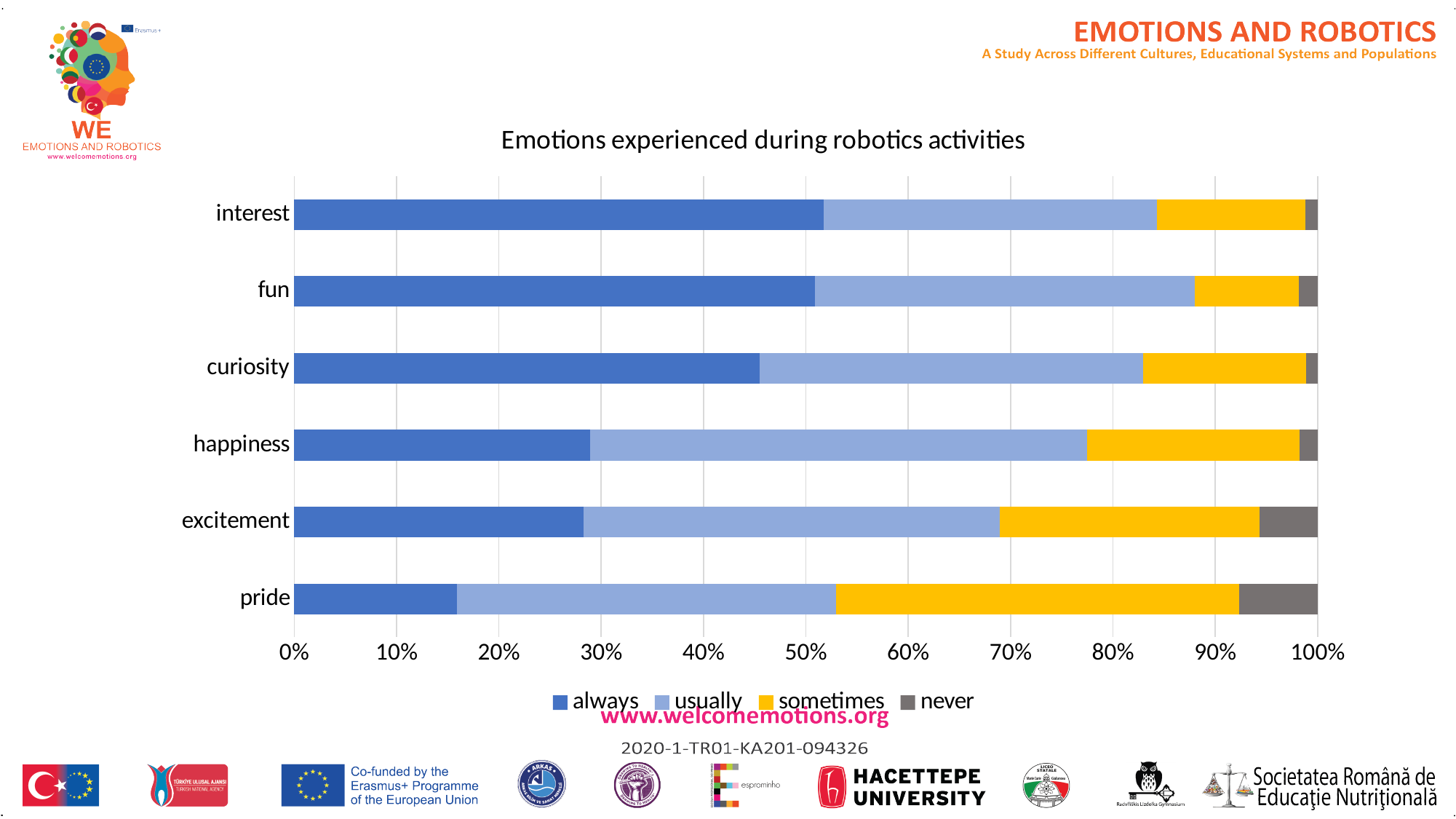
How many series does the legend list? 4 What is the title of the chart? Emotions experienced during robotics activities Is the 'always' share for curiosity greater or less than 50%? less Which emotion has the largest 'never' share? pride Which emotion has the largest 'sometimes' share? pride How many emotion categories are plotted on the chart? 6 Which has a larger 'always' share, curiosity or happiness? curiosity Which series is shown in yellow in the legend? sometimes Is the 'always' share for interest greater or less than 50%? greater Which emotion has the smallest 'always' share? pride Is the 'always' share for pride greater or less than 20%? less What kind of chart is shown on the slide? stacked bar chart